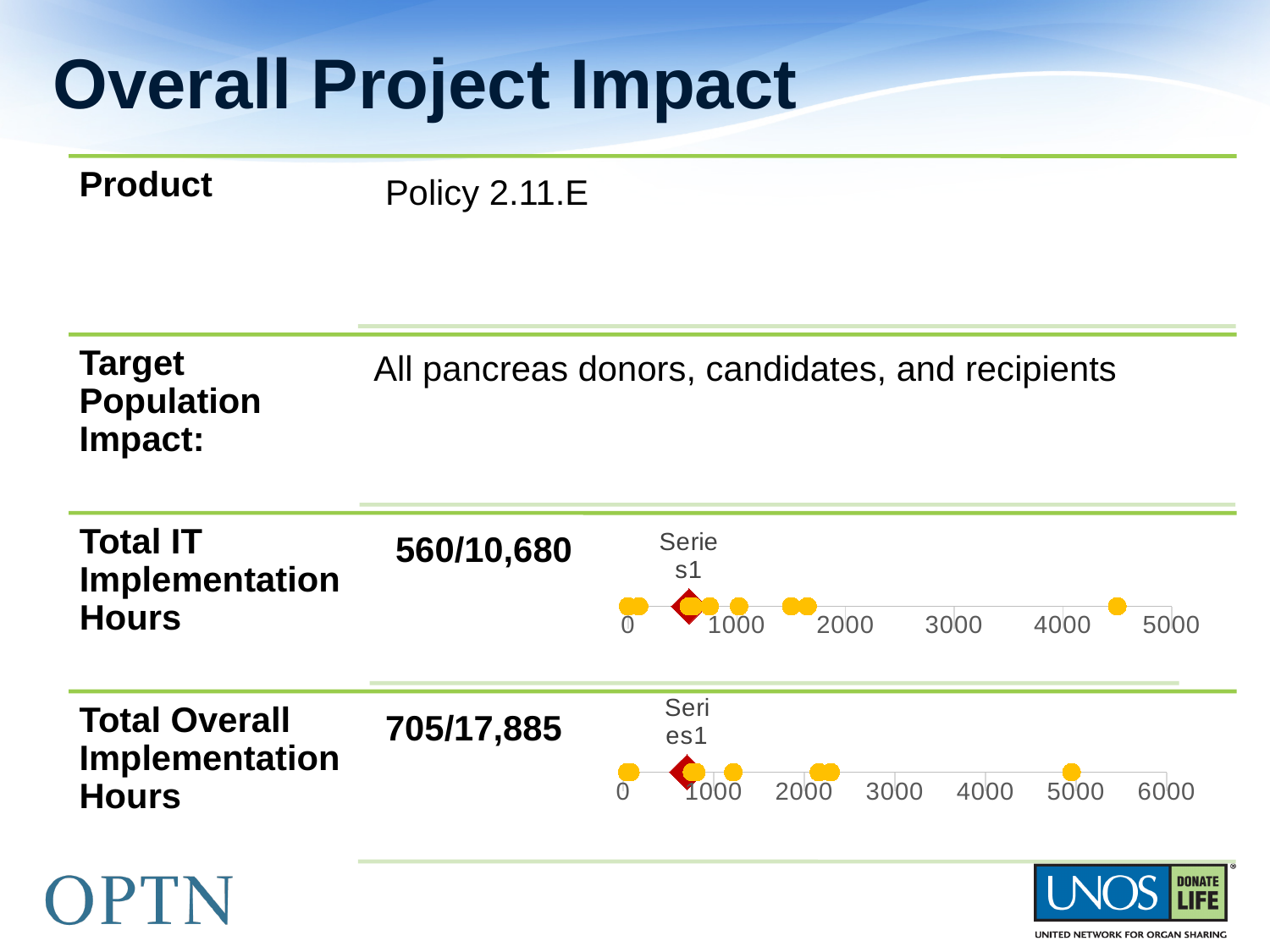
In the Total Overall Implementation Hours chart, what is the name of the series shown in the legend? Series1 In the Total IT Implementation Hours chart, is the rightmost point greater or less than 4000? greater In the Total IT Implementation Hours chart, is the rightmost point greater or less than 5000? less What kind of chart is shown next to Total IT Implementation Hours? scatter chart What kind of chart is shown next to Total Overall Implementation Hours? scatter chart In the Total Overall Implementation Hours chart, what is the highest value labelled on the x axis? 6000 In the Total Overall Implementation Hours chart, is the value marked by the red diamond greater or less than 1000? less In the Total IT Implementation Hours chart, what is the highest value labelled on the x axis? 5000 In the Total IT Implementation Hours chart, how many series does the legend list? 1